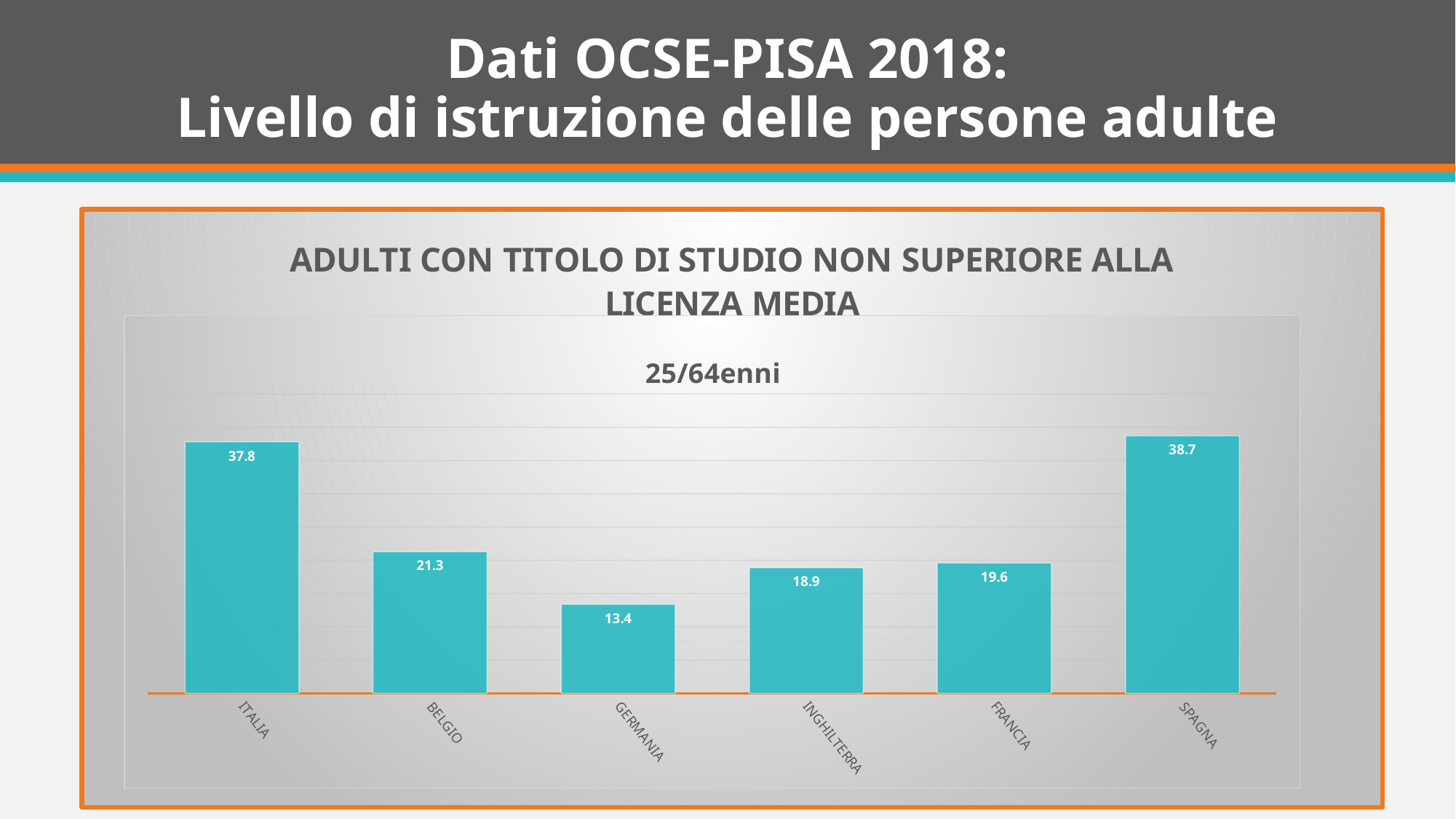
What is the value for INGHILTERRA? 18.9 Which country has the highest value? SPAGNA Which country has the lowest value? GERMANIA What is the difference between the values for SPAGNA and ITALIA? 0.9 What age group is indicated in the chart's subtitle? 25/64enni How many countries are shown in the chart? 6 What is the value for FRANCIA? 19.6 What is the value for GERMANIA? 13.4 What kind of chart is shown on the slide? Bar chart What is the difference between the values for BELGIO and GERMANIA? 7.9 Which is larger, the value for FRANCIA or the value for INGHILTERRA? FRANCIA What is the value for ITALIA? 37.8